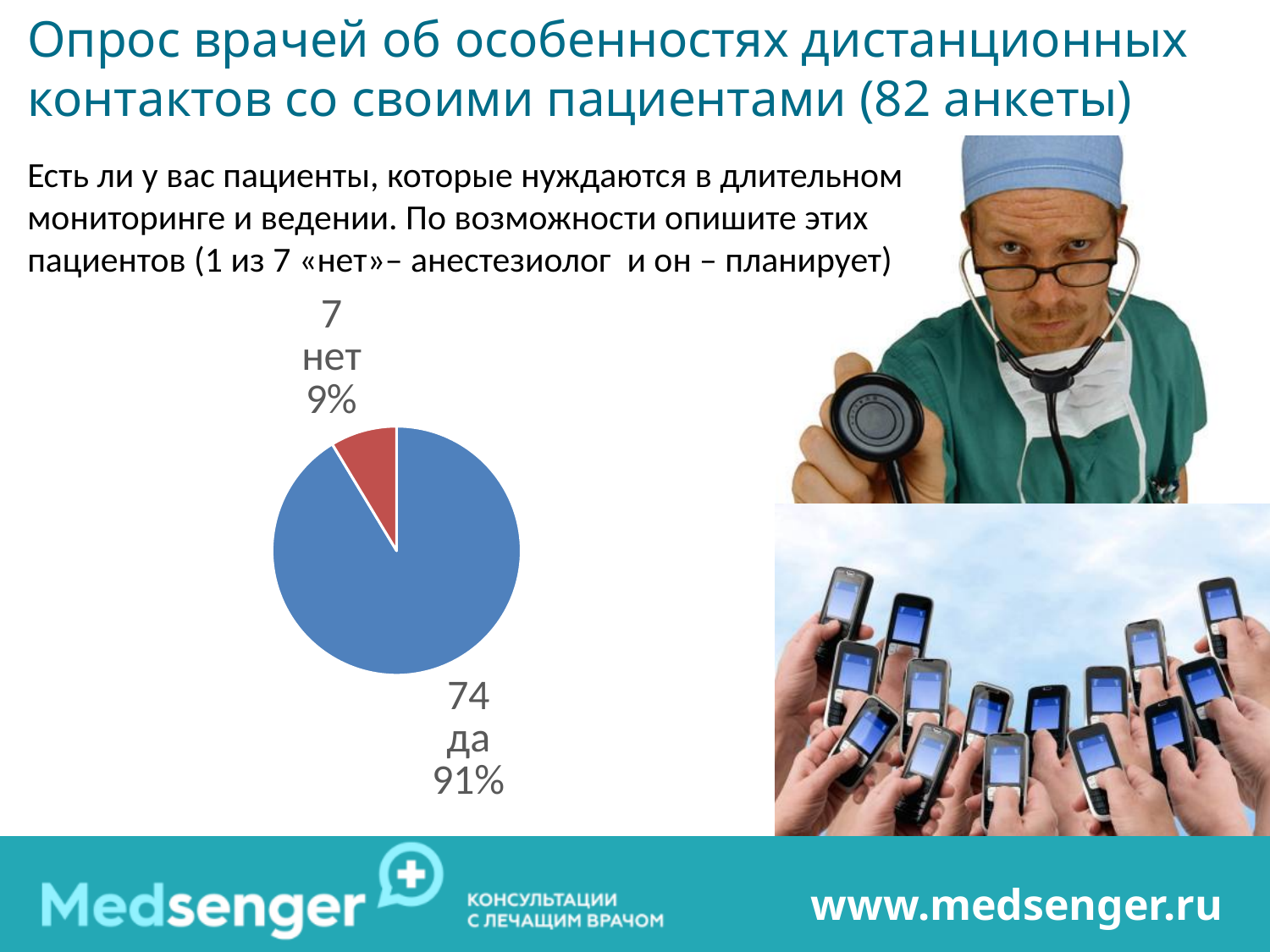
Which is larger in the pie chart, the "да" slice or the "нет" slice? да What share of the pie does the "нет" slice represent? 9% What kind of chart is shown on the slide? pie chart Which slice of the pie chart is the largest? да What share of the pie does the "да" slice represent? 91% Which slice of the pie chart is the smallest? нет How many slices does the pie chart have? 2 What colour is the "нет" slice in the pie chart? red How many respondents answered "да" in the pie chart? 74 What is the difference between the number of "да" and "нет" responses in the pie chart? 67 What is the total number of responses shown in the pie chart? 81 How many respondents answered "нет" in the pie chart? 7